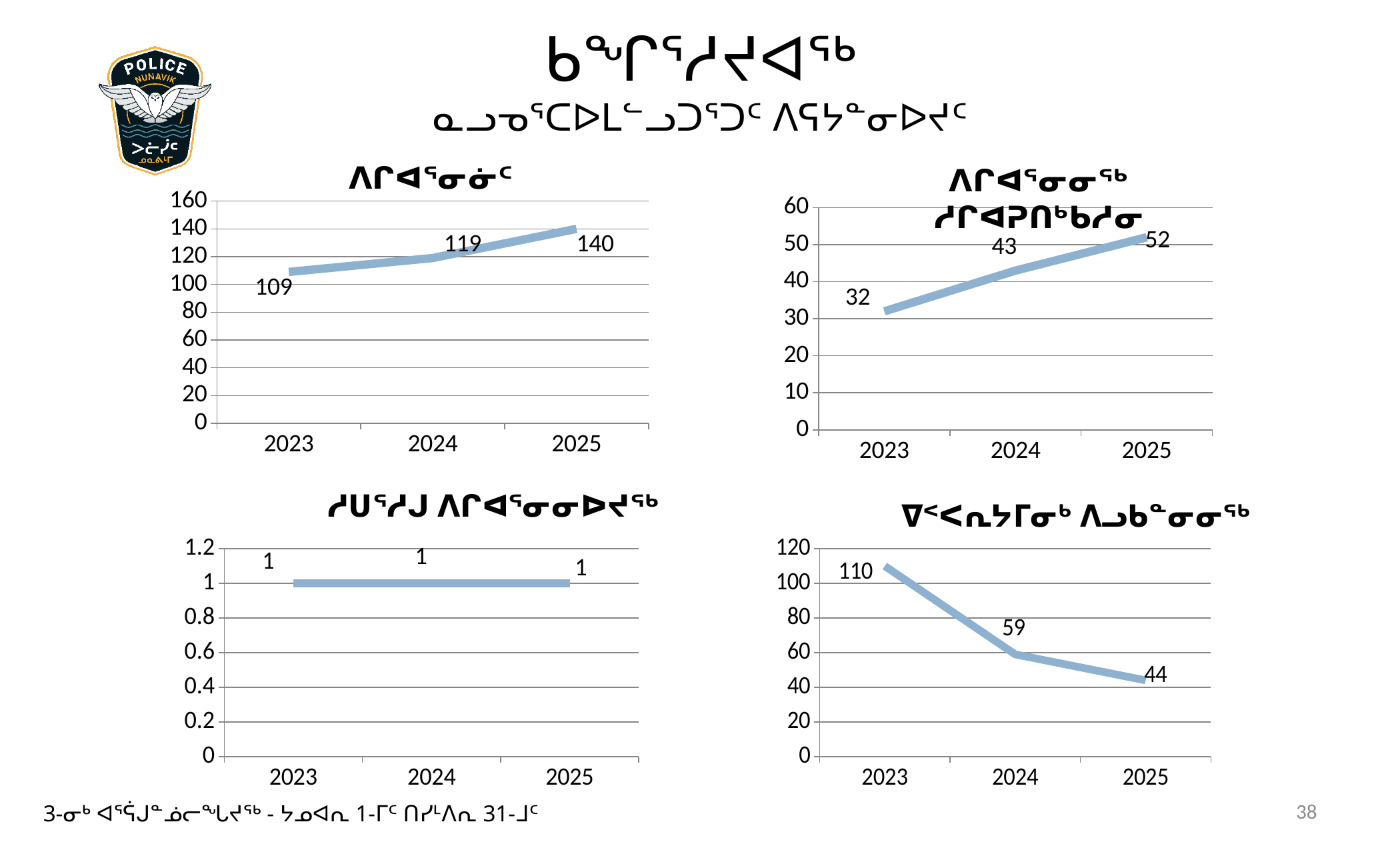
In the top-right chart, which year has the highest value? 2025 What kind of chart is the top-right chart? line chart In the bottom-right chart, what is the difference between the 2023 and 2024 values? 51 In the bottom-right chart, do the values rise or fall from 2023 to 2025? fall In the top-left chart, what is the value for 2025? 140 In the top-left chart, which year has the lowest value? 2023 In the bottom-right chart, what is the value for 2023? 110 How many years are plotted in the bottom-left chart? 3 In the bottom-left chart, what is the value for 2024? 1 In the top-right chart, do the values rise or fall from 2023 to 2025? rise In the top-right chart, what is the value for 2024? 43 In the top-left chart, what is the difference between the 2025 and 2023 values? 31